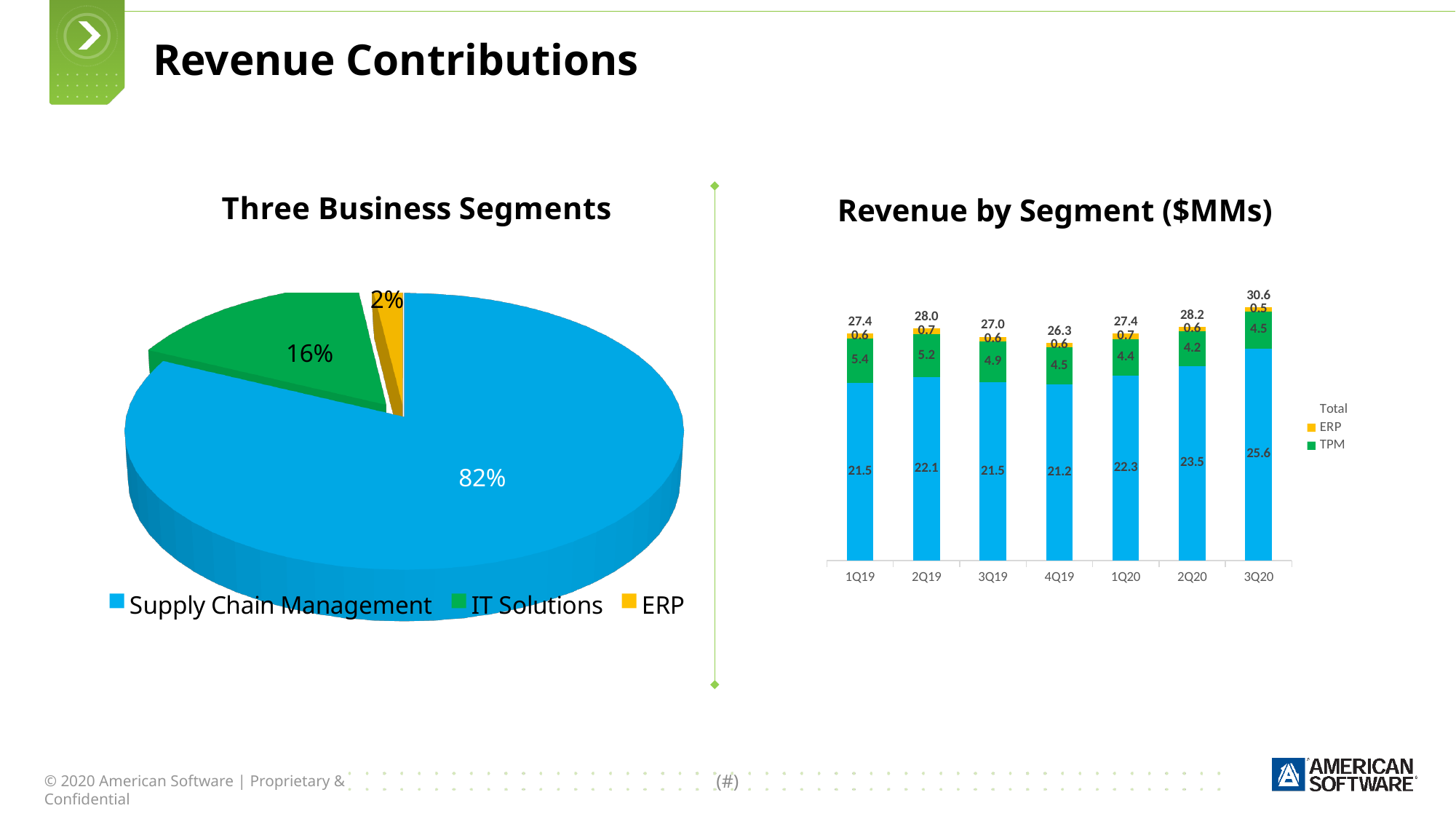
In the Revenue by Segment ($MMs) chart, what is the TPM value for 1Q19? 5.4 How many quarters are shown on the x axis of the Revenue by Segment ($MMs) chart? 7 In the Revenue by Segment ($MMs) chart, what is the difference between the total revenue in 3Q20 and 2Q20? 2.4 What kind of chart is the Three Business Segments chart? Pie chart How many slices does the Three Business Segments pie chart have? 3 In the Revenue by Segment ($MMs) chart, is the TPM value larger in 1Q19 or 3Q20? 1Q19 In the Revenue by Segment ($MMs) chart, what is the ERP value for 2Q19? 0.7 In the Revenue by Segment ($MMs) chart, which quarter has the lowest total revenue? 4Q19 In the Three Business Segments pie chart, what share does Supply Chain Management hold? 82% In the Revenue by Segment ($MMs) chart, what is the total revenue for 3Q20? 30.6 In the Three Business Segments pie chart, what share does IT Solutions hold? 16% In the Three Business Segments pie chart, which segment has the smallest share? ERP